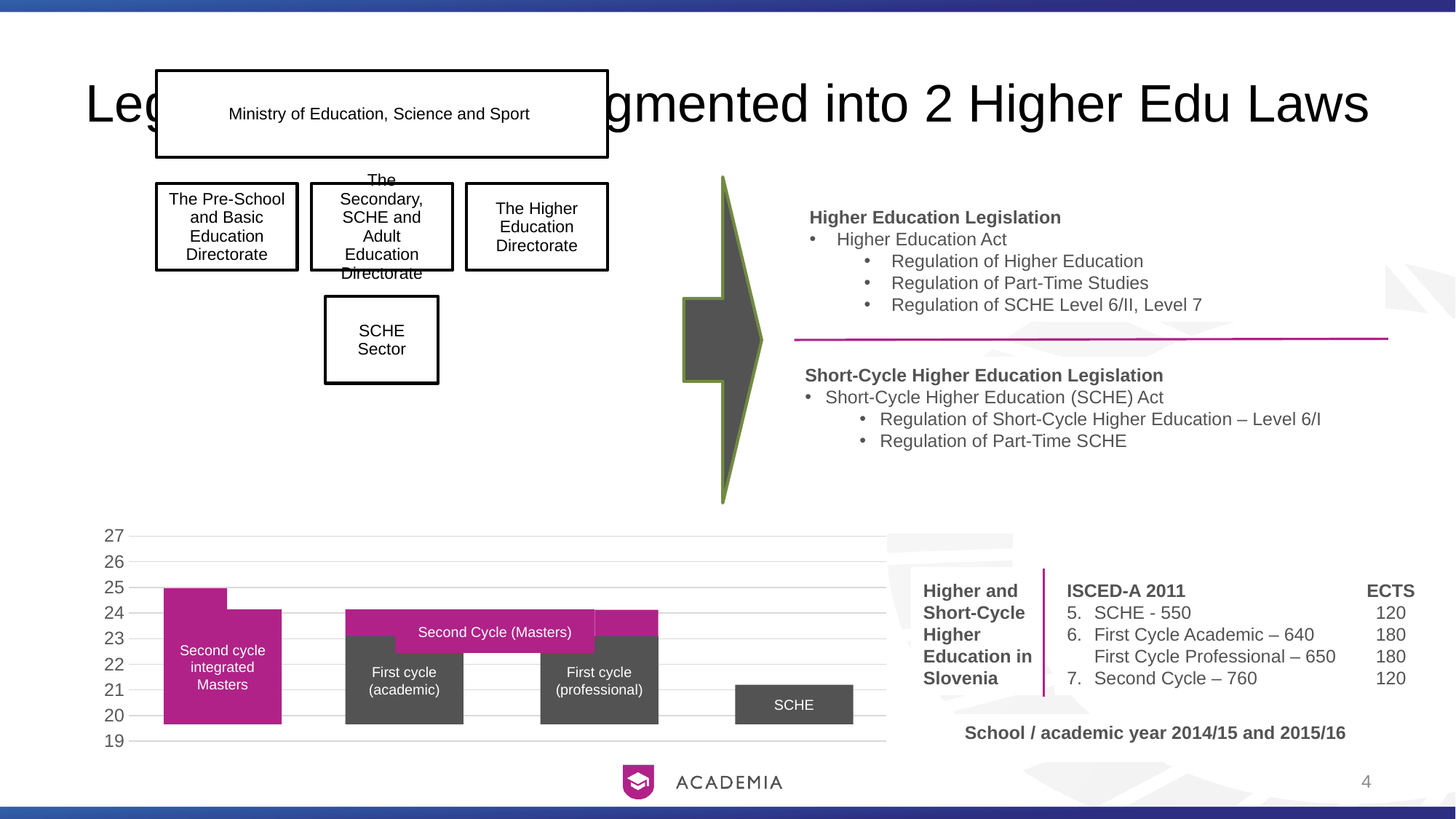
At which y-axis value does the top of the SCHE bar sit? 21 At which y-axis value does the top of the First cycle (academic) bar sit? 23 Which bar in the chart has the lowest top value? SCHE At which y-axis value does the top of the Second Cycle (Masters) bar sit? 24 How many labelled bars does the chart at the bottom of the slide contain? 5 Is the top of the First cycle (professional) bar greater or less than 22? greater What kind of chart is shown at the bottom of the slide? bar chart Which bar in the chart reaches the highest value on the y axis? Second cycle integrated Masters Which bar reaches higher, First cycle (academic) or SCHE? First cycle (academic) What colour is the Second Cycle (Masters) bar? magenta Is the top of the SCHE bar greater or less than 22? less What is the lowest value shown on the chart's y axis? 19